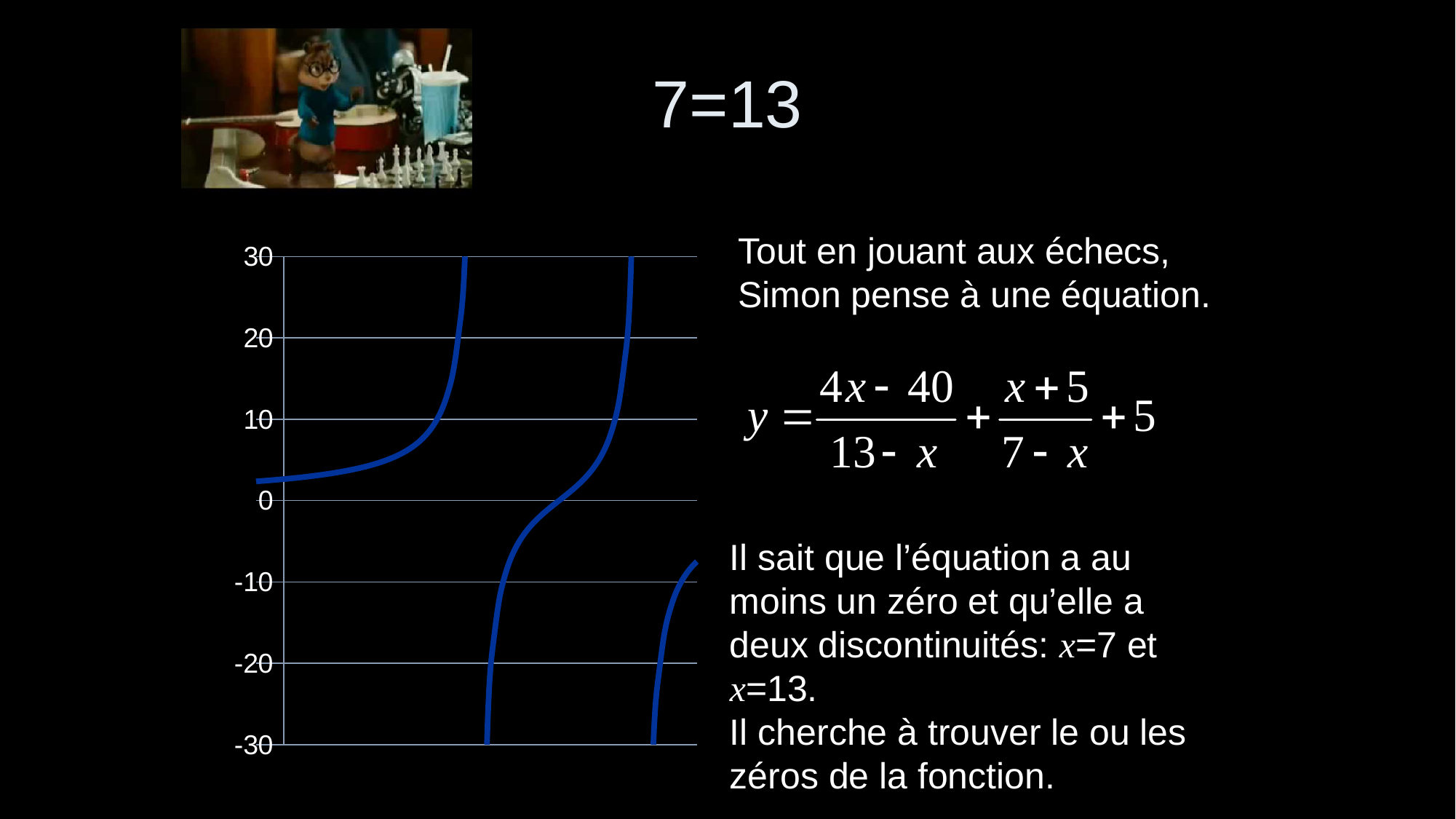
Is the value of the curve at the left edge of the chart greater or less than 10? less Is the value of the curve at the left edge of the chart greater or less than 0? greater What is the highest value labelled on the vertical axis of the chart? 30 Is the value of the curve at the right edge of the chart greater or less than -20? greater Does the leftmost branch of the curve rise or fall as x increases? rise How many tick labels are shown on the vertical axis of the chart? 7 What is the lowest value labelled on the vertical axis of the chart? -30 Into how many separate branches is the plotted curve broken? 3 What kind of chart is shown on the slide? line chart Does the middle branch of the curve rise or fall as x increases? rise